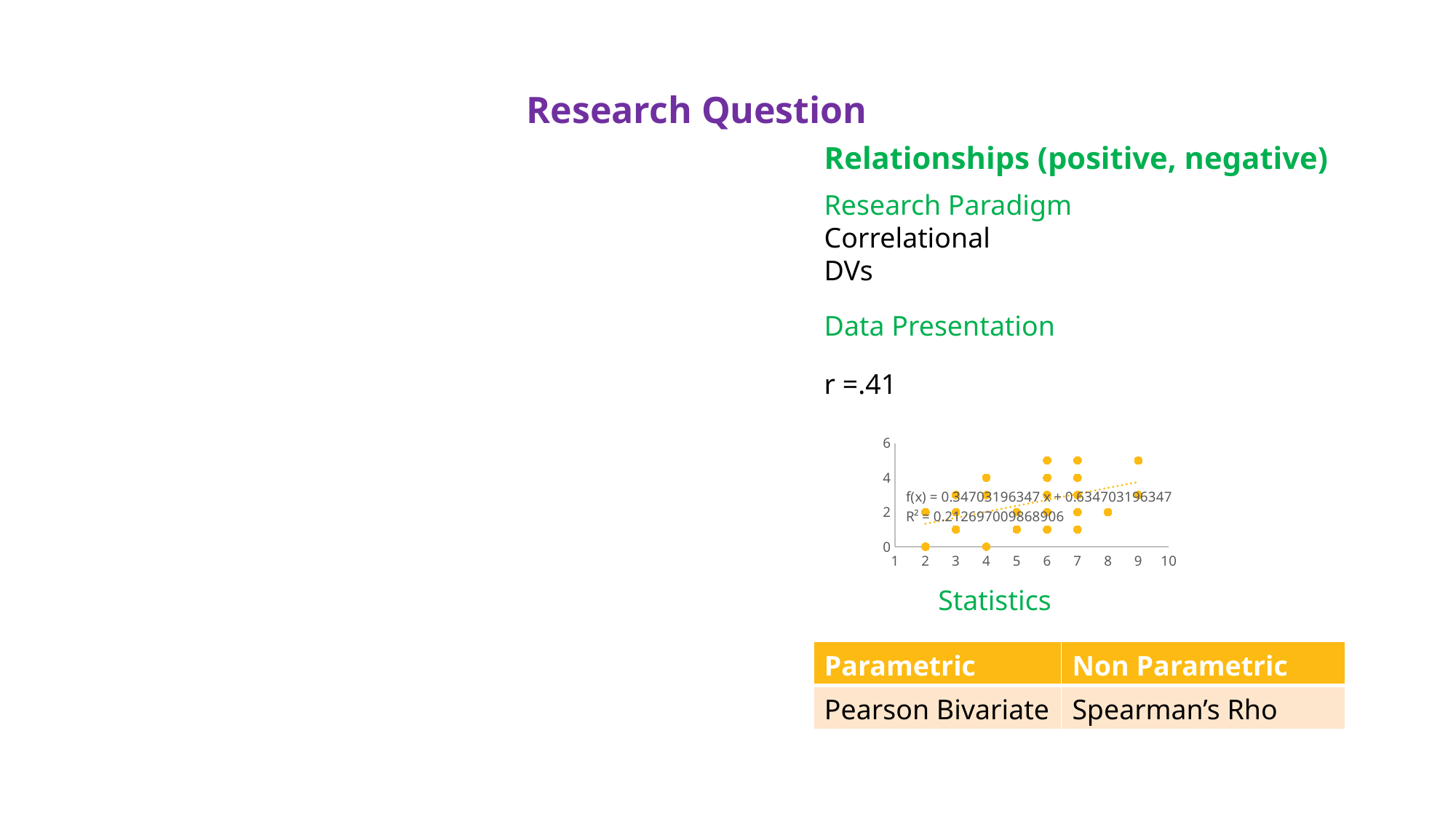
What kind of chart is shown on the slide? scatter chart Is the y value of the highest plotted point greater or less than 4? greater Is the y value of the point at x = 8 greater or less than 4? less What is the largest value labelled on the x axis? 10 What is the highest tick value shown on the y axis? 6 What correlation coefficient (r) is stated above the chart? r =.41 What is the equation of the trendline printed on the chart? f(x) = 0.34703196347 x + 0.634703196347 What is the lowest y value reached by any plotted point? 0 What is the smallest value labelled on the x axis? 1 What R² value is printed on the chart? 0.212697009868906 Do the plotted points generally rise or fall as the x value increases? rise